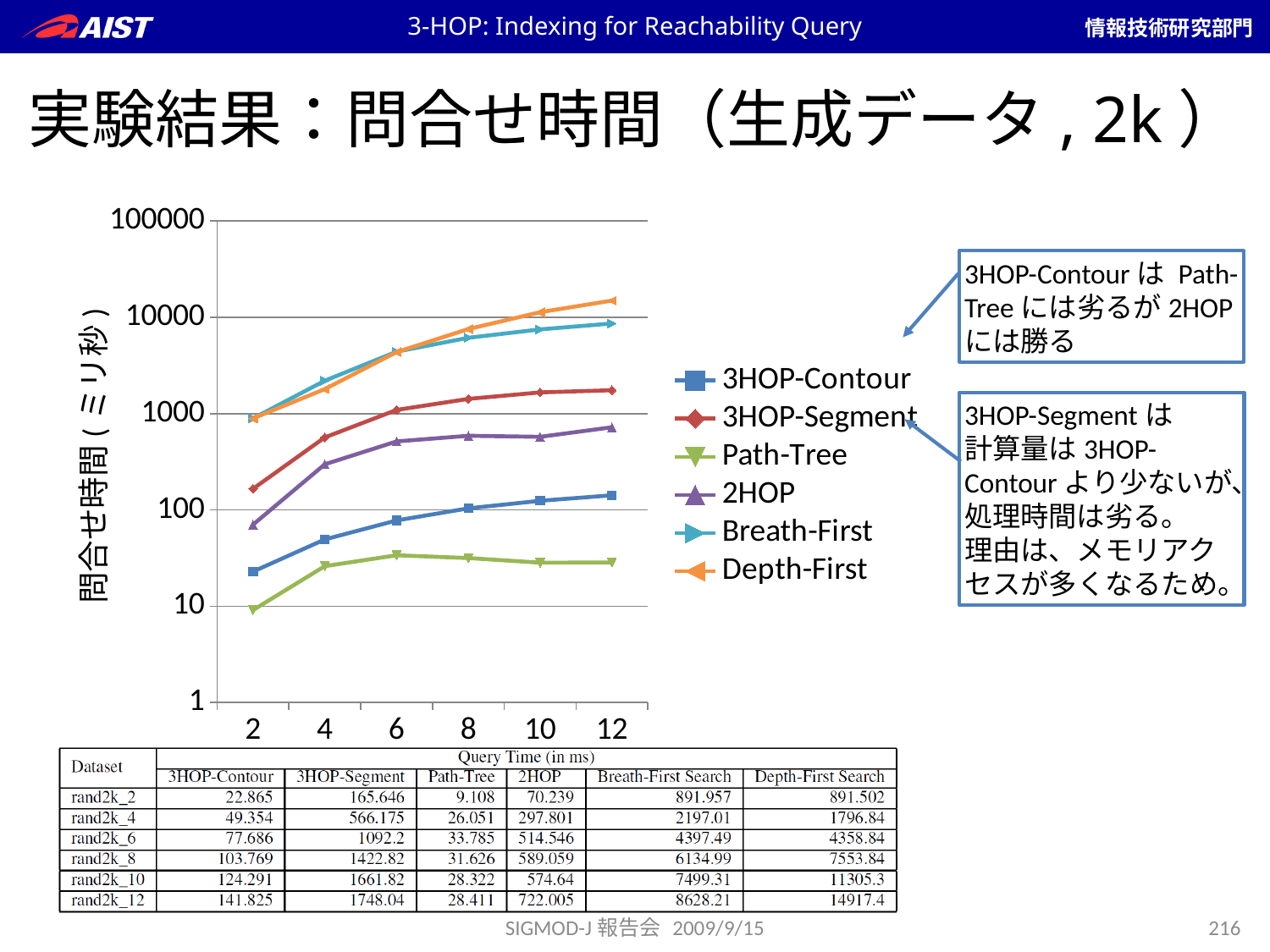
Does the 3HOP-Contour series rise or fall as x increases from 2 to 12? rise Is the value for Path-Tree at x = 2 greater or less than 10? less At x = 6, which is larger: 3HOP-Contour or 2HOP? 2HOP Which series has the highest value at x = 12? Depth-First How many x-axis points does each series in the chart have? 6 What is the query time for 3HOP-Contour at x = 2 (rand2k_2)? 22.865 Which series has the lowest value at x = 12? Path-Tree How many series does the chart's legend list? 6 What kind of chart is shown on the slide? line chart Is the value for 3HOP-Segment at x = 6 greater or less than 1000? greater What is the query time for Path-Tree at x = 6 (rand2k_6)? 33.785 What is the difference between the 3HOP-Contour values at x = 12 and x = 2? 118.96